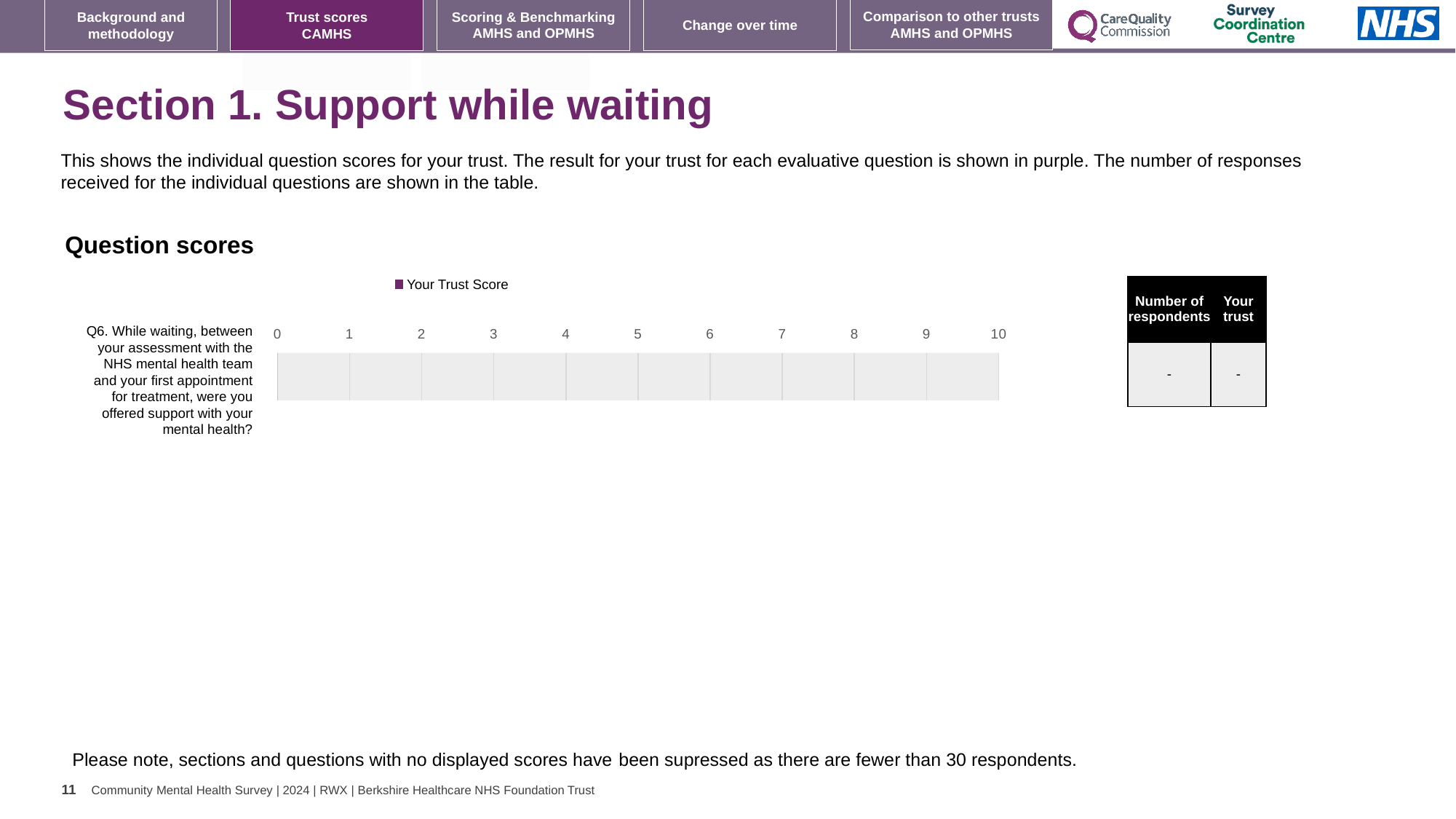
What is the maximum value shown on the axis of the 'Question scores' chart? 10 What is the name of the series in the legend of the 'Question scores' chart? Your Trust Score Which question number is shown as the category on the 'Question scores' chart? Q6 What is the minimum value shown on the axis of the 'Question scores' chart? 0 How many questions (categories) are listed on the 'Question scores' chart? 1 Is a bar plotted for Q6 on the 'Question scores' chart? No How many series does the legend of the 'Question scores' chart list? 1 What kind of chart is shown under the heading 'Question scores'? Bar chart